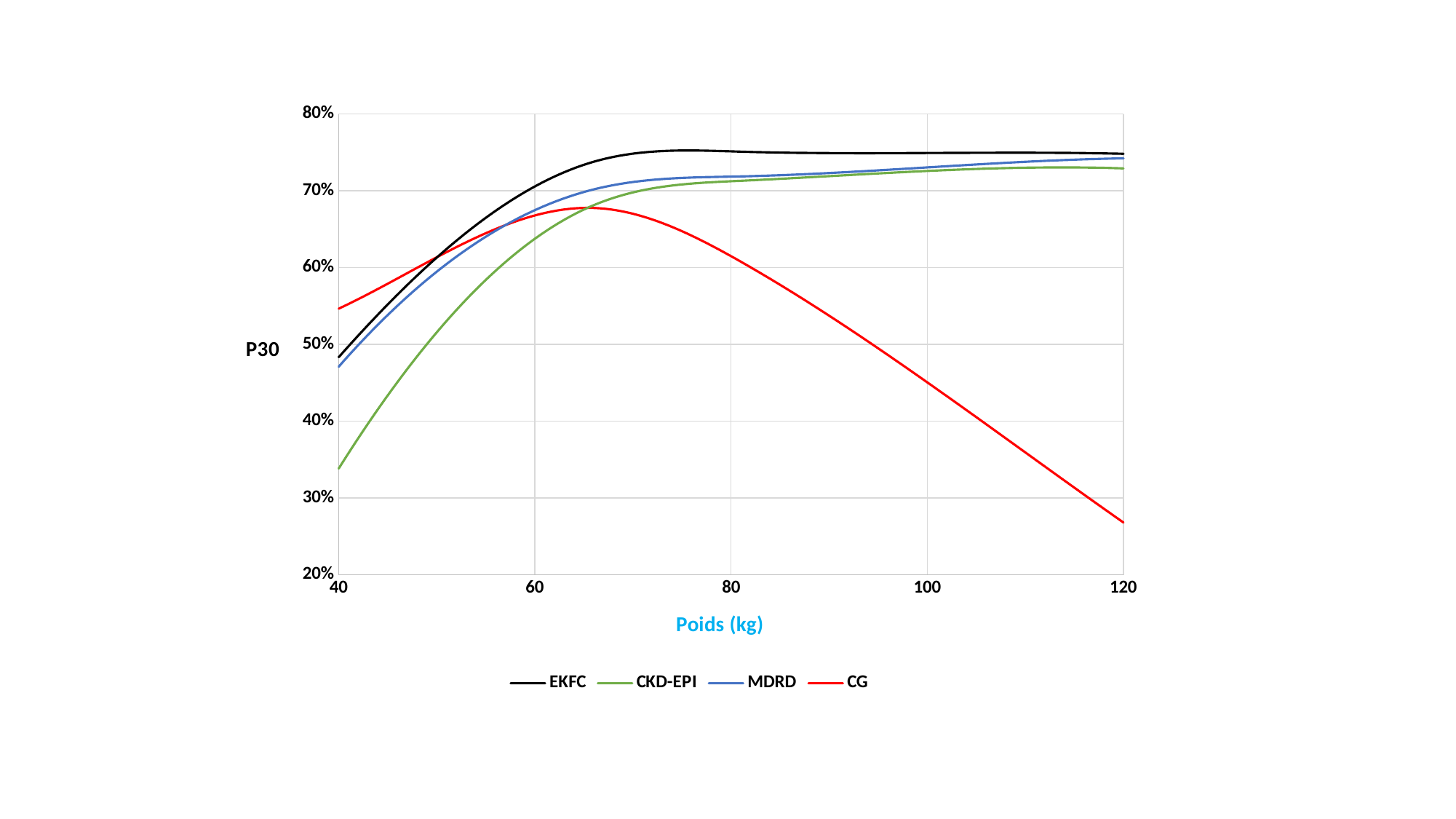
Does the CKD-EPI line rise or fall between 40 kg and 60 kg? rise At 120 kg, which series has the larger value, EKFC or CG? EKFC What kind of chart is shown on the slide? line chart Is the value for CKD-EPI at 40 kg greater or less than 40%? less What are the series names listed in the legend? EKFC, CKD-EPI, MDRD, CG Does the CG line rise or fall between 80 kg and 120 kg? fall Which series has the lowest value at 40 kg? CKD-EPI What is the title of the x axis? Poids (kg) How many series does the legend list? 4 Is the value for MDRD at 40 kg greater or less than 50%? less Is the value for EKFC at 80 kg greater or less than 70%? greater